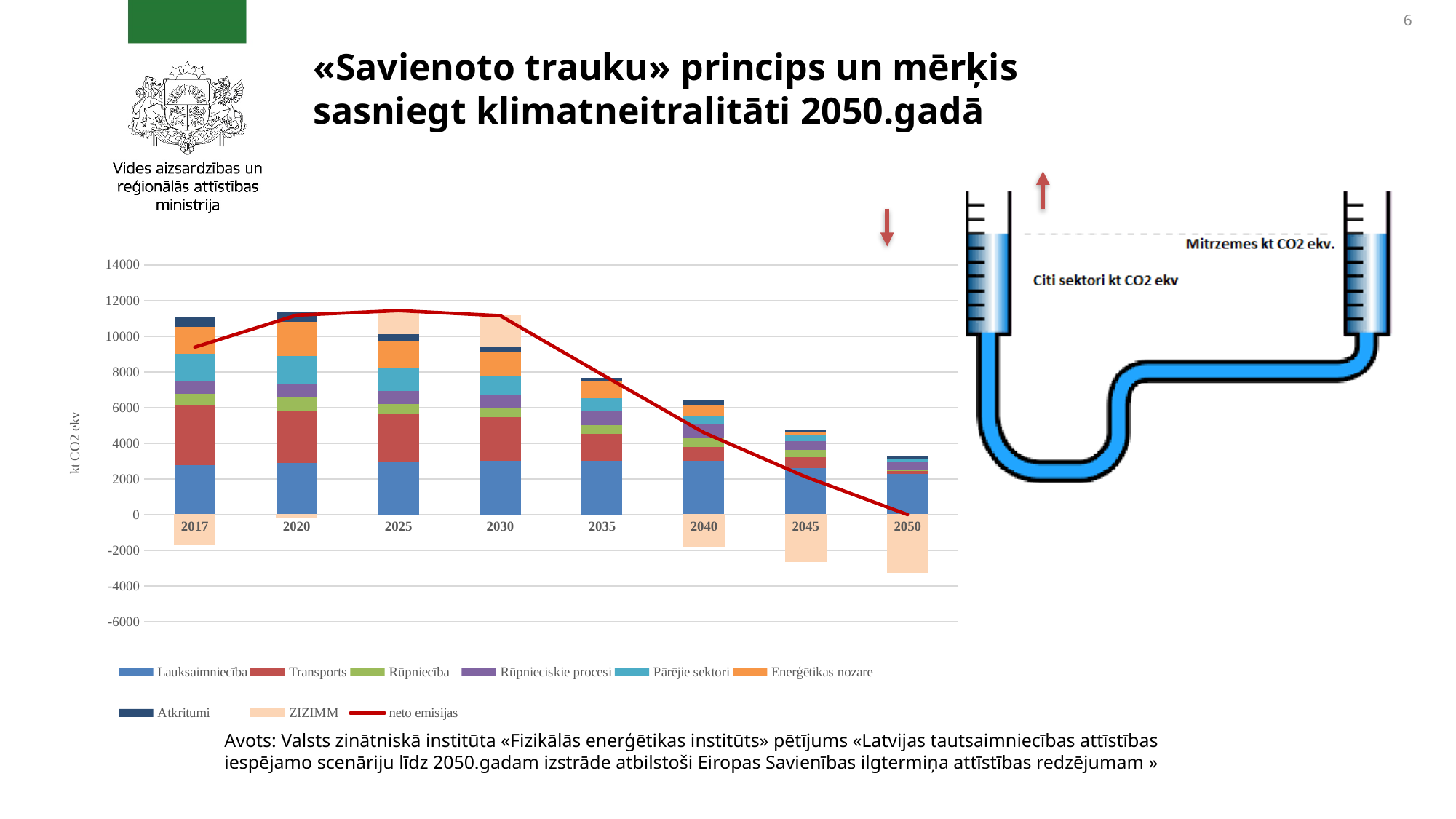
Is the neto emisijas value for 2025 greater or less than 10000? greater Is the neto emisijas value for 2040 greater or less than 6000? less In which year does the neto emisijas line reach its lowest value? 2050 How many entries does the chart legend list? 9 Is the neto emisijas value for 2017 greater or less than 10000? less Which legend entry is drawn as a red line rather than a bar segment? neto emisijas How many years are shown on the x axis of the chart? 8 What kind of chart is shown on the slide? stacked bar chart with a line What is the label of the vertical axis of the chart? kt CO2 ekv In which year does the neto emisijas line reach its highest value? 2025 From 2030 to 2050, does the neto emisijas line rise or fall? fall Which year has the larger negative ZIZIMM bar, 2017 or 2050? 2050